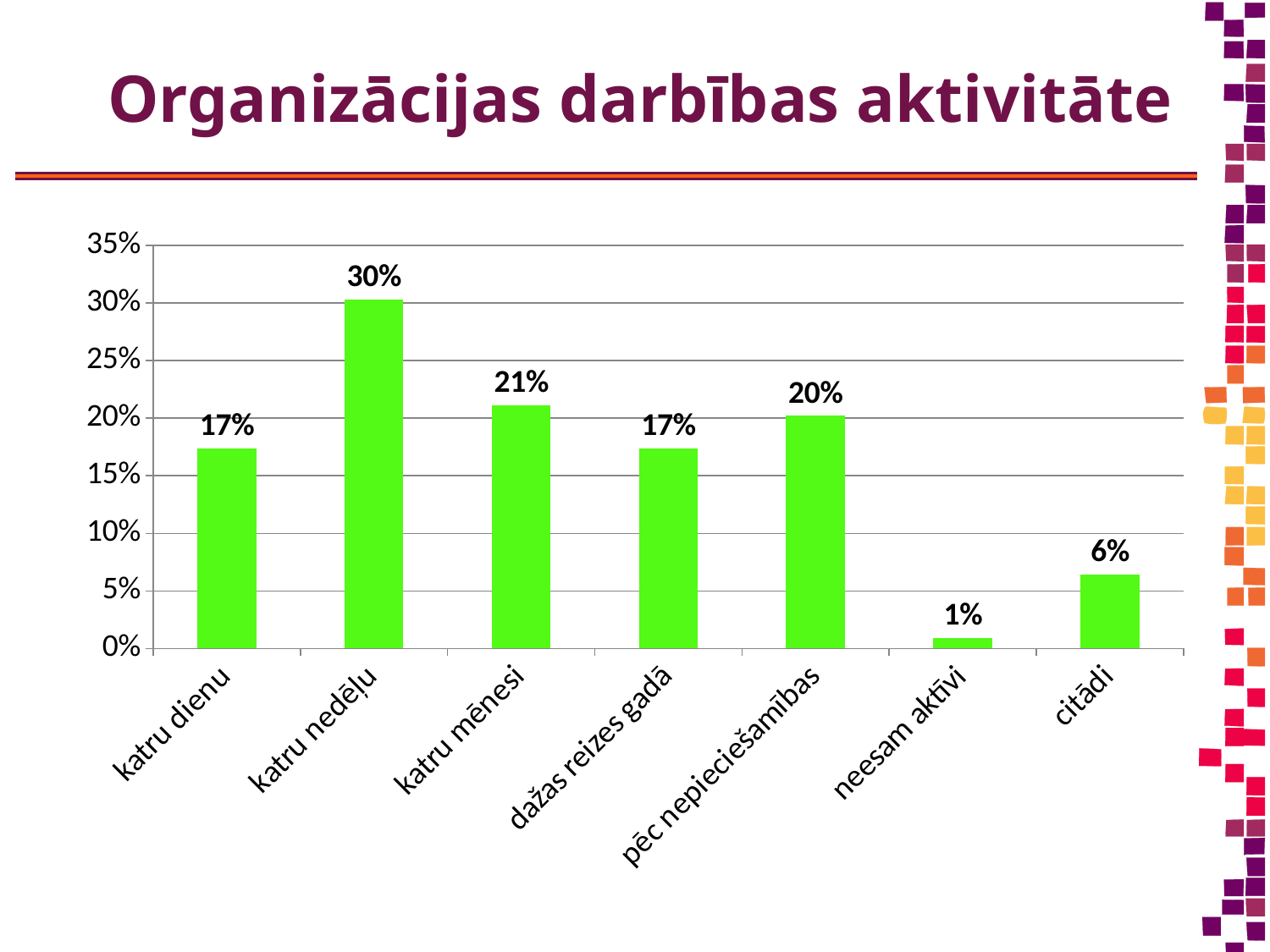
What is the difference between the values for "katru nedēļu" and "katru mēnesi"? 9% Which category has the highest value? katru nedēļu What is the value for "neesam aktīvi"? 1% Which is larger, the value for "katru mēnesi" or the value for "citādi"? katru mēnesi Is the value for "katru nedēļu" greater or less than 25%? greater Which category has the lowest value? neesam aktīvi What is the value for "katru nedēļu"? 30% How many categories are shown on the x axis? 7 What is the value for "pēc nepieciešamības"? 20% What is the value for "citādi"? 6% What kind of chart is shown on the slide? bar chart What is the title of the slide? Organizācijas darbības aktivitāte